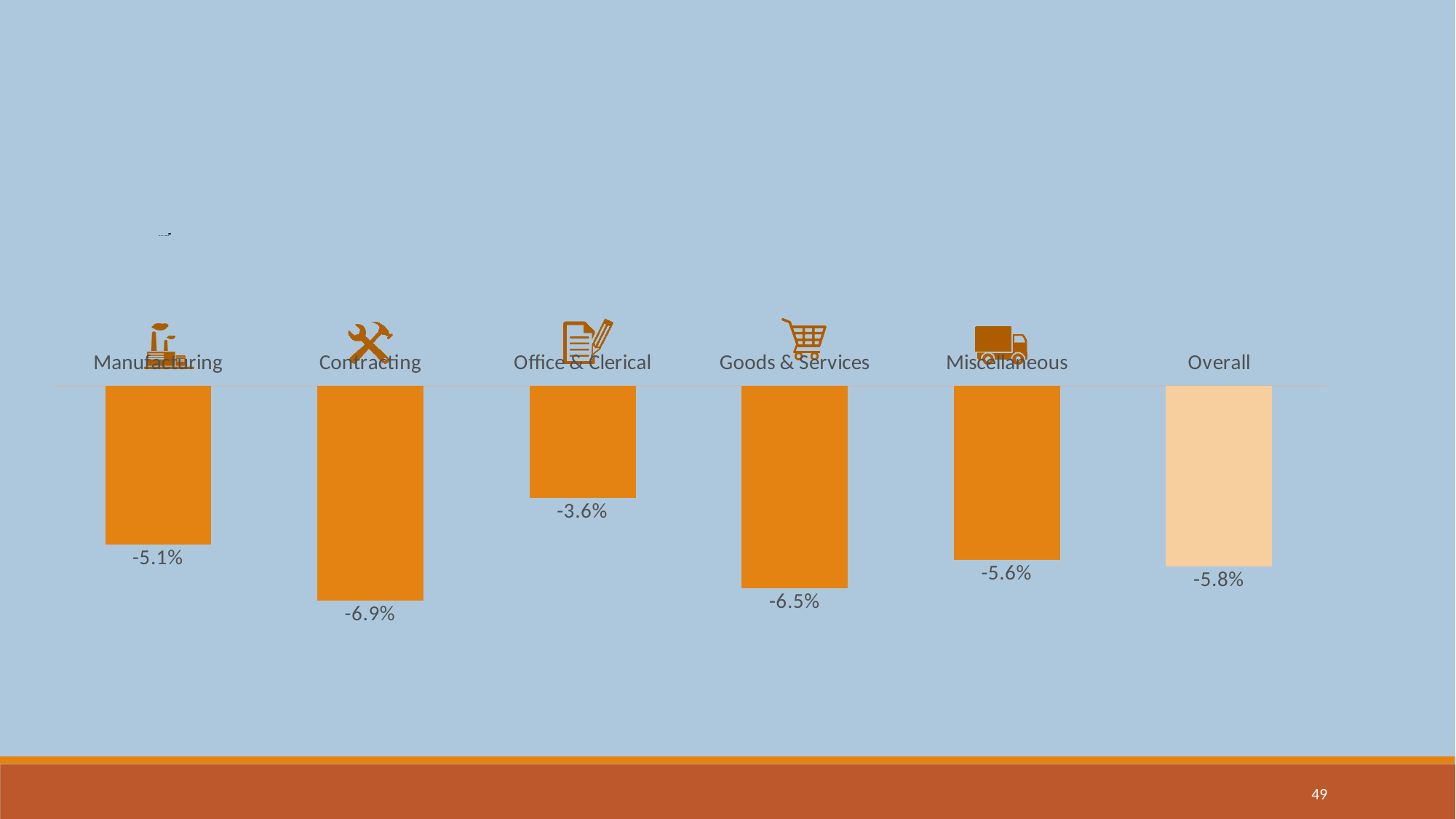
Which category shows the largest decline (the lowest value)? Contracting What is the value shown for Contracting? -6.9% What kind of chart is shown on the slide? Bar chart Which bar is shown in a lighter colour than the others? Overall How many categories are plotted in the chart? 6 What is the value shown for Goods & Services? -6.5% Which has a larger decline, Goods & Services or Miscellaneous? Goods & Services Which category shows the smallest decline (the highest value)? Office & Clerical What is the value shown for Overall? -5.8% What is the difference in percentage points between the Contracting value and the Office & Clerical value? 3.3 percentage points What is the value shown for Office & Clerical? -3.6% What is the value shown for Manufacturing? -5.1%